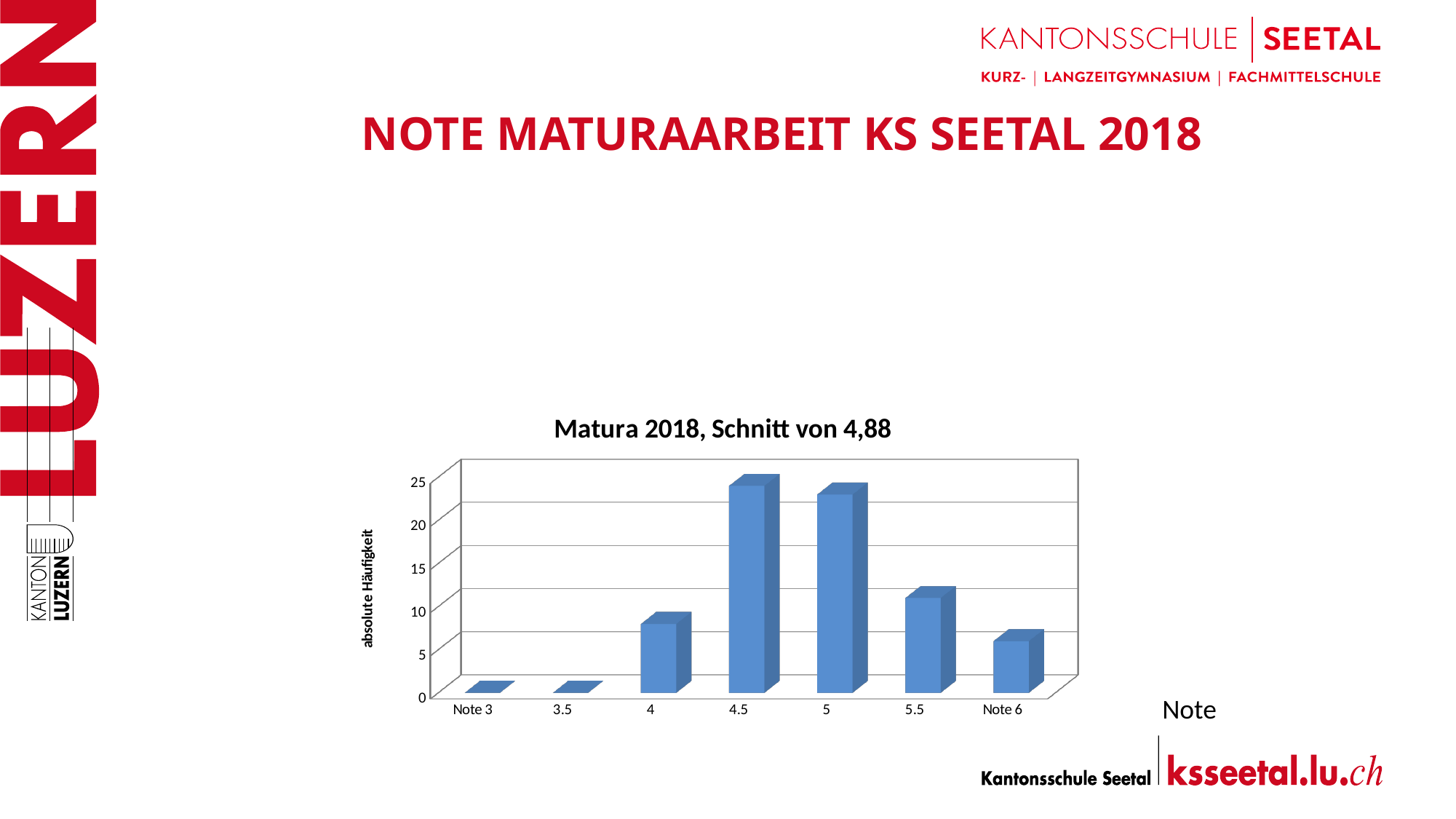
Is the value for 4 greater or less than 5? greater What kind of chart is shown on the slide? bar chart What is the label of the vertical axis of the chart? absolute Häufigkeit Is the value for Note 6 greater or less than 10? less Is the value for 4.5 greater or less than 20? greater How many grade categories are shown on the x axis of the chart? 7 Which has the larger value, 4 or 5.5? 5.5 What is the title of the chart? Matura 2018, Schnitt von 4,88 Do the values rise or fall along the x axis from 4.5 to Note 6? fall Which has the larger value, 4.5 or Note 6? 4.5